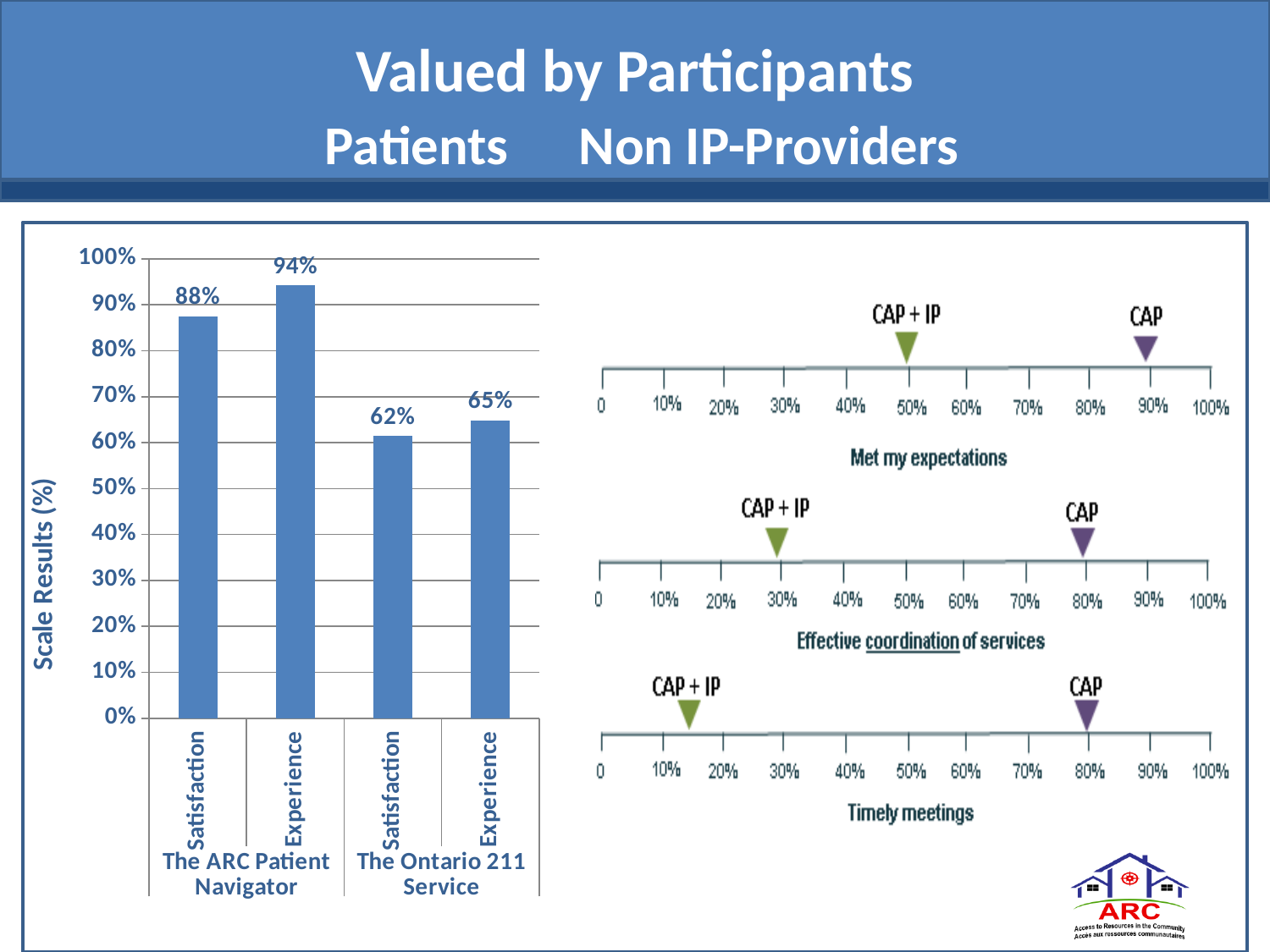
In the bar chart on the left, how many bars are plotted? 4 In the bar chart on the left, what is the label of the vertical axis? Scale Results (%) In the bar chart on the left, what is the difference between the Experience values for The ARC Patient Navigator and The Ontario 211 Service? 29% In the 'Timely meetings' scale on the right, is the CAP + IP marker greater or less than 30%? less In the 'Effective coordination of services' scale on the right, is the CAP + IP marker greater or less than 40%? less In the bar chart on the left, which bar has the highest value? The ARC Patient Navigator Experience What kind of chart is shown on the left side of the slide? Bar chart In the bar chart on the left, what is the Satisfaction value for The ARC Patient Navigator? 88% In the bar chart on the left, which is larger: Satisfaction for The ARC Patient Navigator or Satisfaction for The Ontario 211 Service? The ARC Patient Navigator In the 'Met my expectations' scale on the right, is the CAP marker greater or less than 80%? greater In the bar chart on the left, what is the Experience value for The Ontario 211 Service? 65% In the bar chart on the left, which bar has the lowest value? The Ontario 211 Service Satisfaction